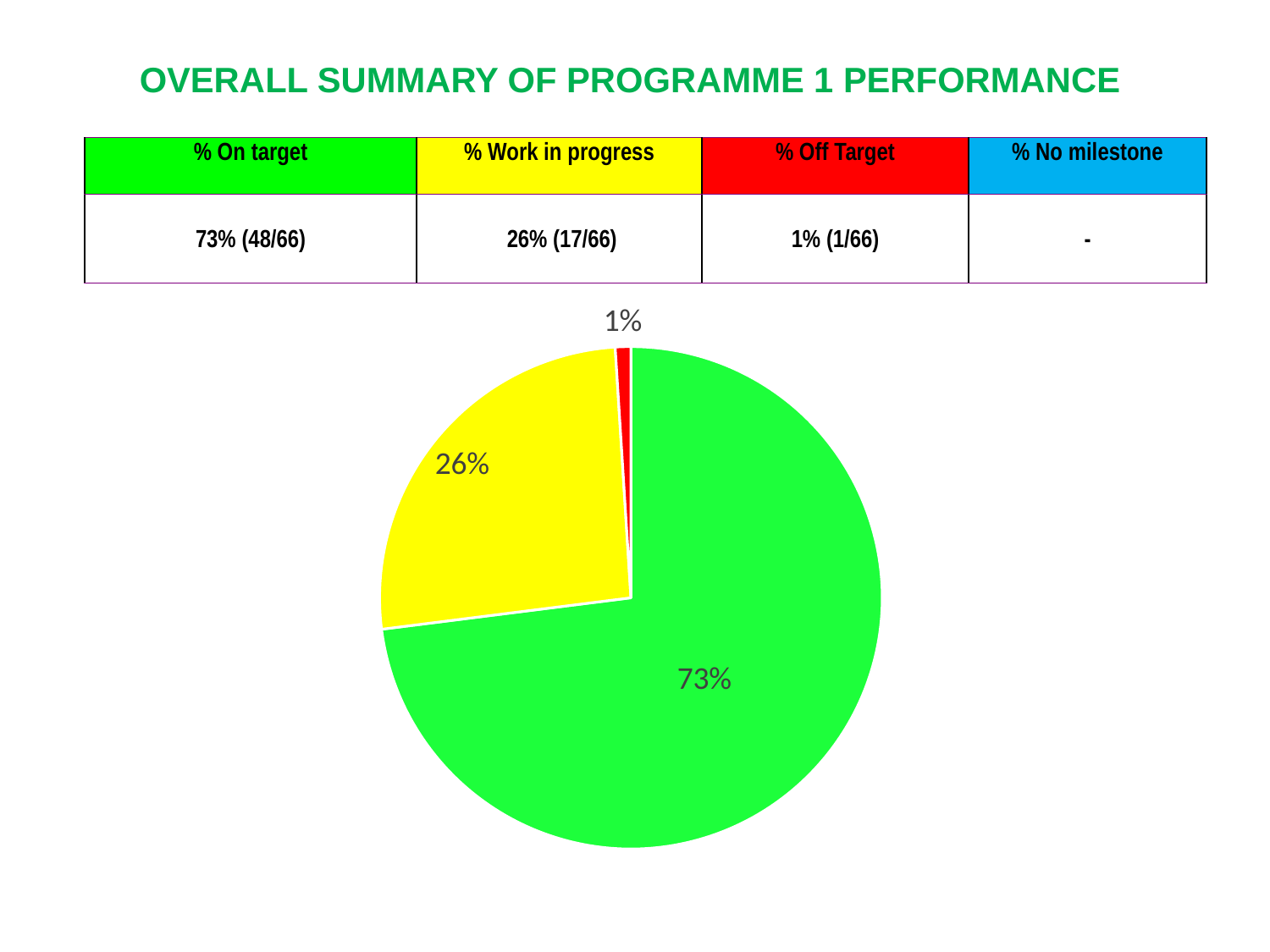
Which slice of the pie chart is the smallest? 1% (red, Off Target) Is the share of the green slice greater or less than 50%? greater What kind of chart is shown on the slide? pie chart What share of the pie does the yellow slice represent? 26% What colour is the slice labelled 26% in the pie chart? yellow According to the table above the chart, which category does the green slice of the pie correspond to? % On target What is the difference between the green slice and the yellow slice of the pie chart? 47% Which is larger in the pie chart, the yellow slice or the red slice? the yellow slice Which slice of the pie chart is the largest? 73% (green, On target) How many slices does the pie chart have? 3 What share of the pie does the green slice represent? 73% What share of the pie does the red slice represent? 1%